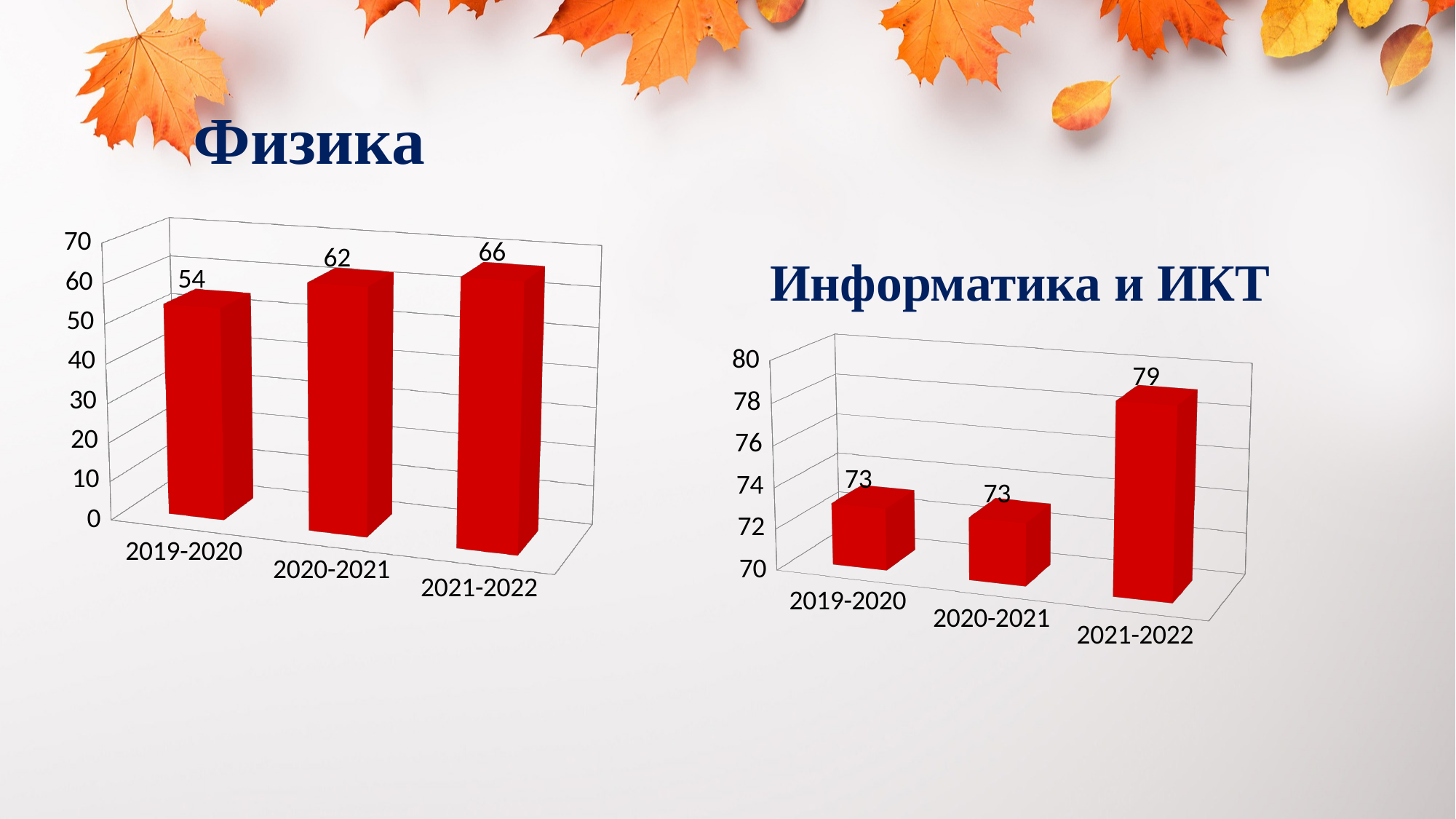
In the Информатика и ИКТ chart, what is the difference between the values for 2021-2022 and 2019-2020? 6 In the Физика chart, which year has the lowest value? 2019-2020 In the Физика chart, do the values rise or fall from 2019-2020 to 2021-2022? rise In the Физика chart, how many categories are shown? 3 In the Физика chart, what is the value for 2019-2020? 54 In the Информатика и ИКТ chart, what is the value for 2021-2022? 79 What kind of chart is the Физика chart? bar chart In the Физика chart, what is the difference between the values for 2021-2022 and 2019-2020? 12 In the Информатика и ИКТ chart, is the value for 2021-2022 greater or less than 76? greater In the Информатика и ИКТ chart, what is the value for 2020-2021? 73 In the Физика chart, what is the value for 2021-2022? 66 In the Информатика и ИКТ chart, which year has the highest value? 2021-2022